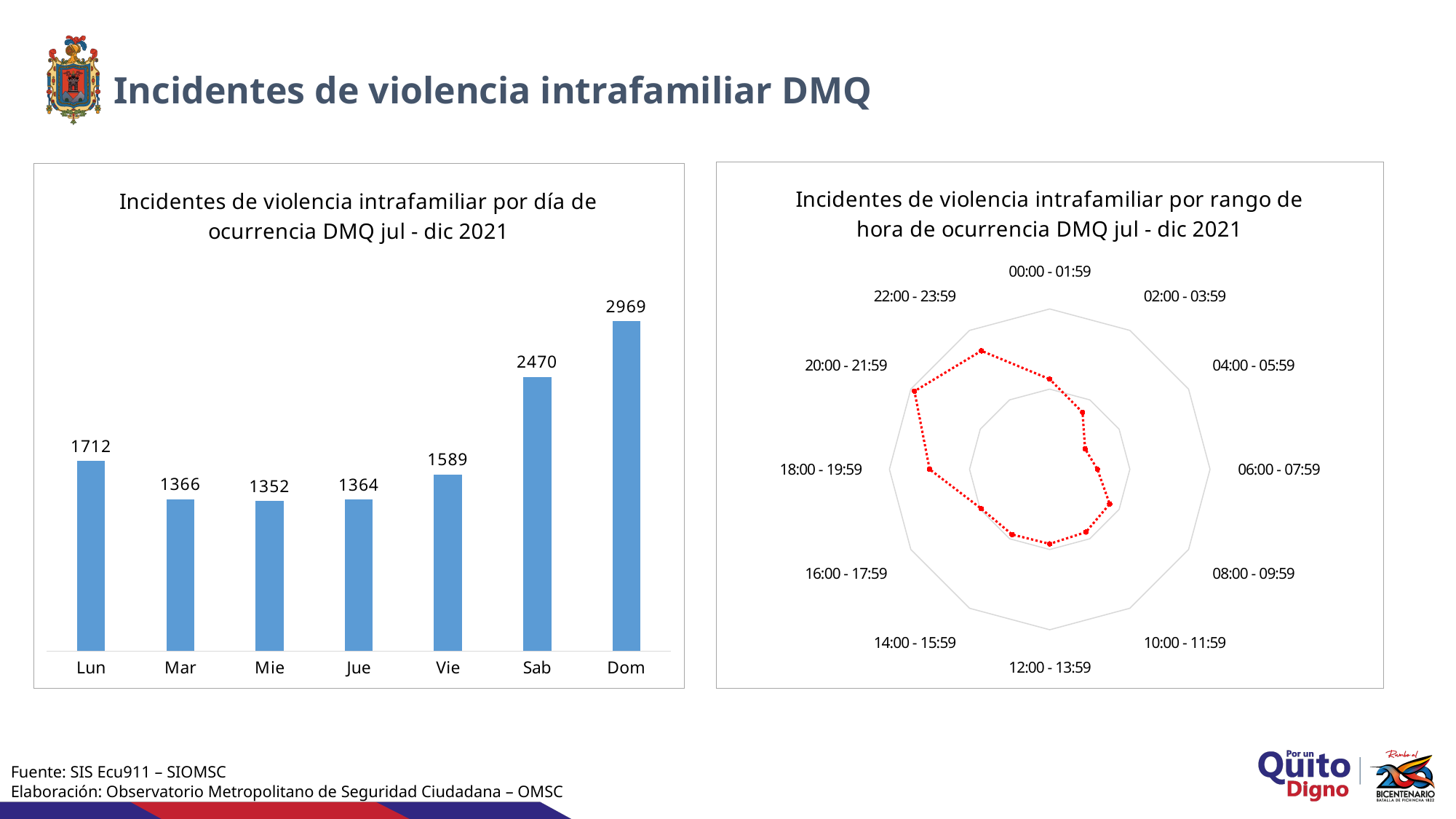
In the bar chart on the left, what is the value for Vie? 1589 In the bar chart on the left, how many incidents are shown for Dom? 2969 In the radar chart on the right, which time range has the highest value? 20:00 - 21:59 How many days are shown in the bar chart on the left? 7 In the bar chart on the left, what is the difference between the values for Dom and Sab? 499 In the bar chart on the left, what is the difference between the values for Lun and Mar? 346 In the bar chart on the left, which is larger, the value for Lun or the value for Vie? Lun In the bar chart on the left, which day has the highest number of incidents? Dom In the bar chart on the left, which day has the lowest number of incidents? Mie What kind of chart is the chart on the right? Radar chart How many time ranges are shown in the radar chart on the right? 12 What kind of chart is the chart on the left? Bar chart